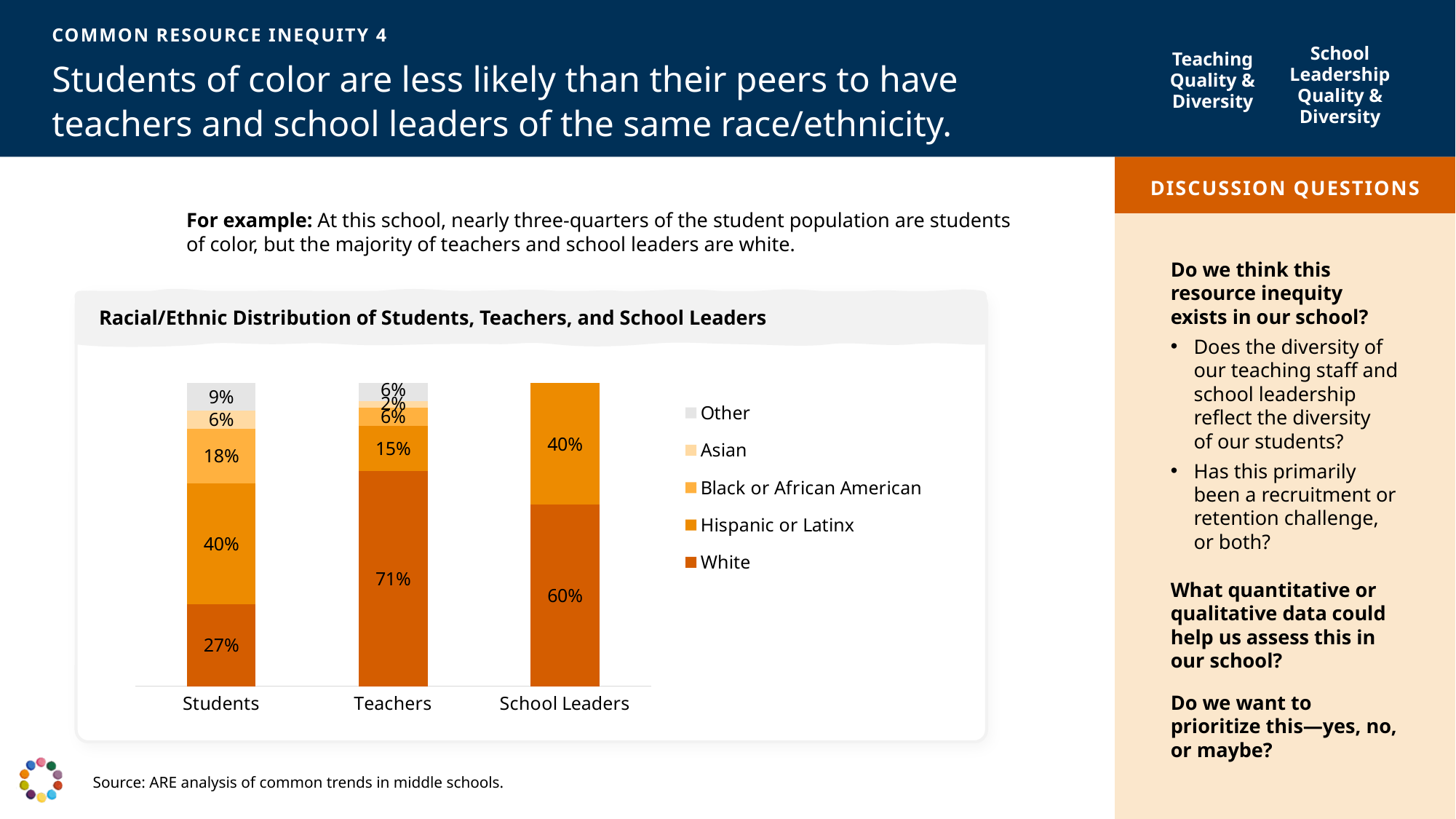
What percentage of school leaders are Hispanic or Latinx? 40% Which group (Students, Teachers, or School Leaders) has the lowest share of White individuals? Students What is the title of the chart? Racial/Ethnic Distribution of Students, Teachers, and School Leaders What kind of chart is shown on the slide? Stacked bar chart What percentage of students are White? 27% Which group (Students, Teachers, or School Leaders) has the highest share of White individuals? Teachers Is the Hispanic or Latinx share larger for Students or for Teachers? Students What percentage of teachers are White? 71% What percentage of students are Black or African American? 18% What is the difference between the White share of teachers and the White share of students? 44 percentage points How many series does the chart legend list? 5 How many categories are shown on the x axis of the chart? 3